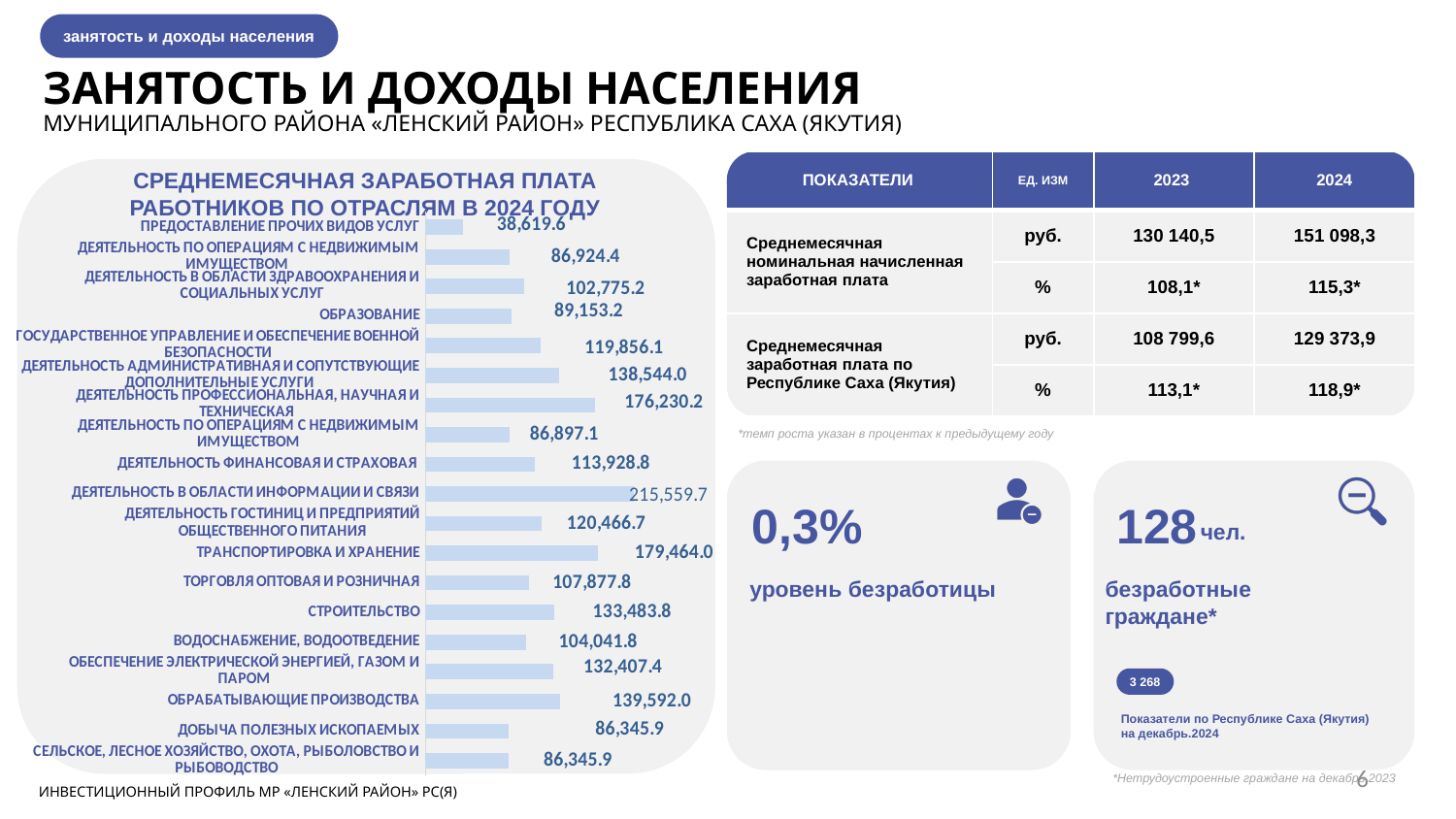
How many categories (industries) are plotted in the chart? 19 What is the title of the chart on the slide? СРЕДНЕМЕСЯЧНАЯ ЗАРАБОТНАЯ ПЛАТА РАБОТНИКОВ ПО ОТРАСЛЯМ В 2024 ГОДУ What type of chart is shown on the slide? Bar chart What is the value for ОБРАЗОВАНИЕ in the chart? 89,153.2 What is the value for ДОБЫЧА ПОЛЕЗНЫХ ИСКОПАЕМЫХ in the chart? 86,345.9 What is the difference between the values for ТРАНСПОРТИРОВКА И ХРАНЕНИЕ and ДЕЯТЕЛЬНОСТЬ ПРОФЕССИОНАЛЬНАЯ, НАУЧНАЯ И ТЕХНИЧЕСКАЯ? 3,233.8 What is the difference between the values for ОБРАБАТЫВАЮЩИЕ ПРОИЗВОДСТВА and ДЕЯТЕЛЬНОСТЬ АДМИНИСТРАТИВНАЯ И СОПУТСТВУЮЩИЕ ДОПОЛНИТЕЛЬНЫЕ УСЛУГИ? 1,048.0 Which has the larger value: ТОРГОВЛЯ ОПТОВАЯ И РОЗНИЧНАЯ or ВОДОСНАБЖЕНИЕ, ВОДООТВЕДЕНИЕ? ТОРГОВЛЯ ОПТОВАЯ И РОЗНИЧНАЯ What is the value for ТРАНСПОРТИРОВКА И ХРАНЕНИЕ in the chart? 179,464.0 Which industry has the lowest average monthly salary in the chart? ПРЕДОСТАВЛЕНИЕ ПРОЧИХ ВИДОВ УСЛУГ What is the value for СТРОИТЕЛЬСТВО in the chart? 133,483.8 Which industry has the highest average monthly salary in the chart? ДЕЯТЕЛЬНОСТЬ В ОБЛАСТИ ИНФОРМАЦИИ И СВЯЗИ